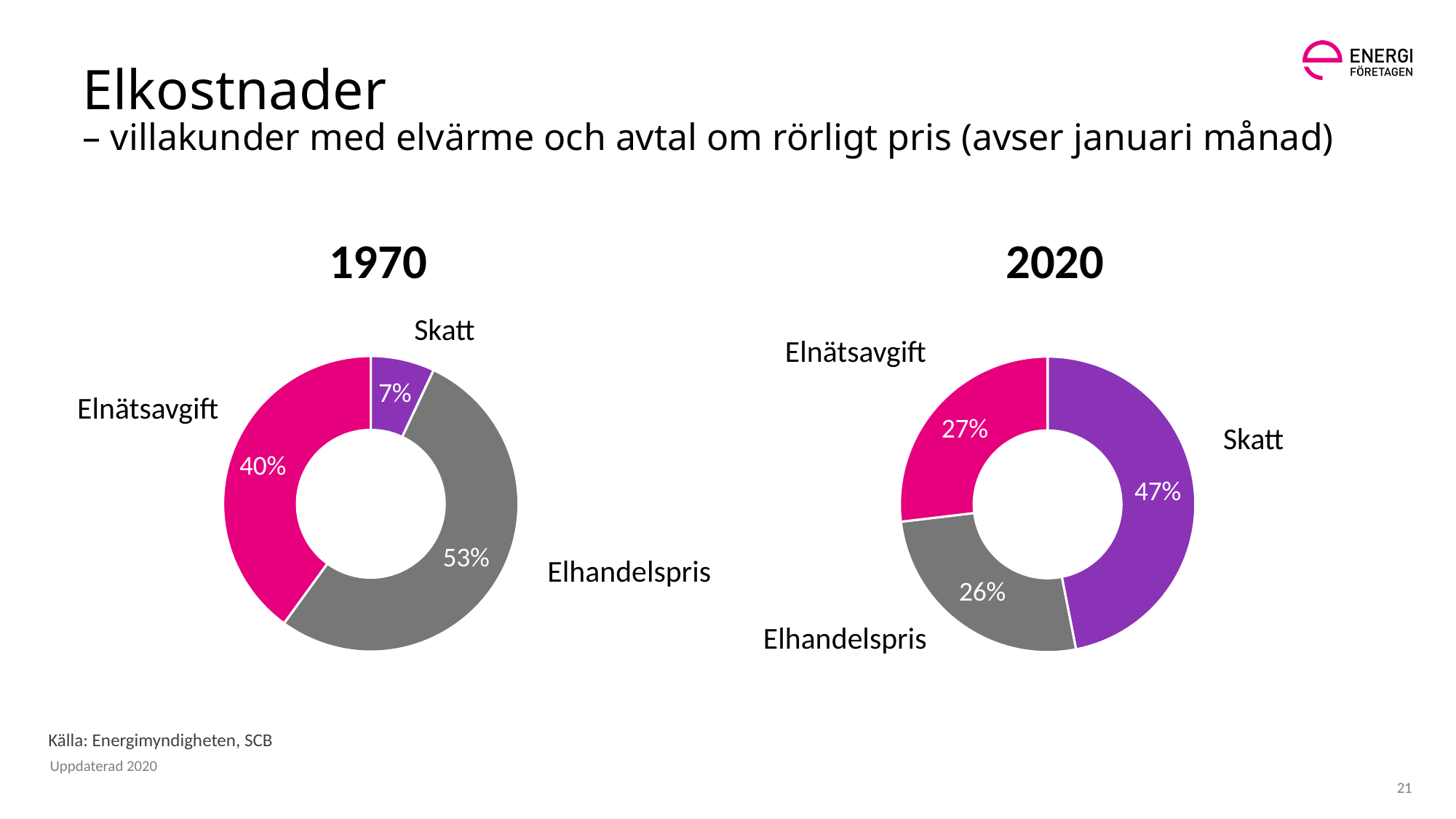
How many categories does the 1970 chart show? 3 In the 1970 chart, what colour is the Elnätsavgift slice? Magenta In the 1970 chart, what share does Skatt have? 7% In the 2020 chart, which category has the smallest share? Elhandelspris In the 2020 chart, what share does Elhandelspris have? 26% In the 1970 chart, which category has the largest share? Elhandelspris What kind of chart is the 2020 chart? Doughnut chart In the 1970 chart, what share does Elnätsavgift have? 40% In the 2020 chart, what share does Skatt have? 47% In the 1970 chart, what is the difference in percentage points between Elhandelspris and Skatt? 46 In the 2020 chart, which is larger, Elnätsavgift or Elhandelspris? Elnätsavgift In the 2020 chart, what is the difference in percentage points between Skatt and Elnätsavgift? 20